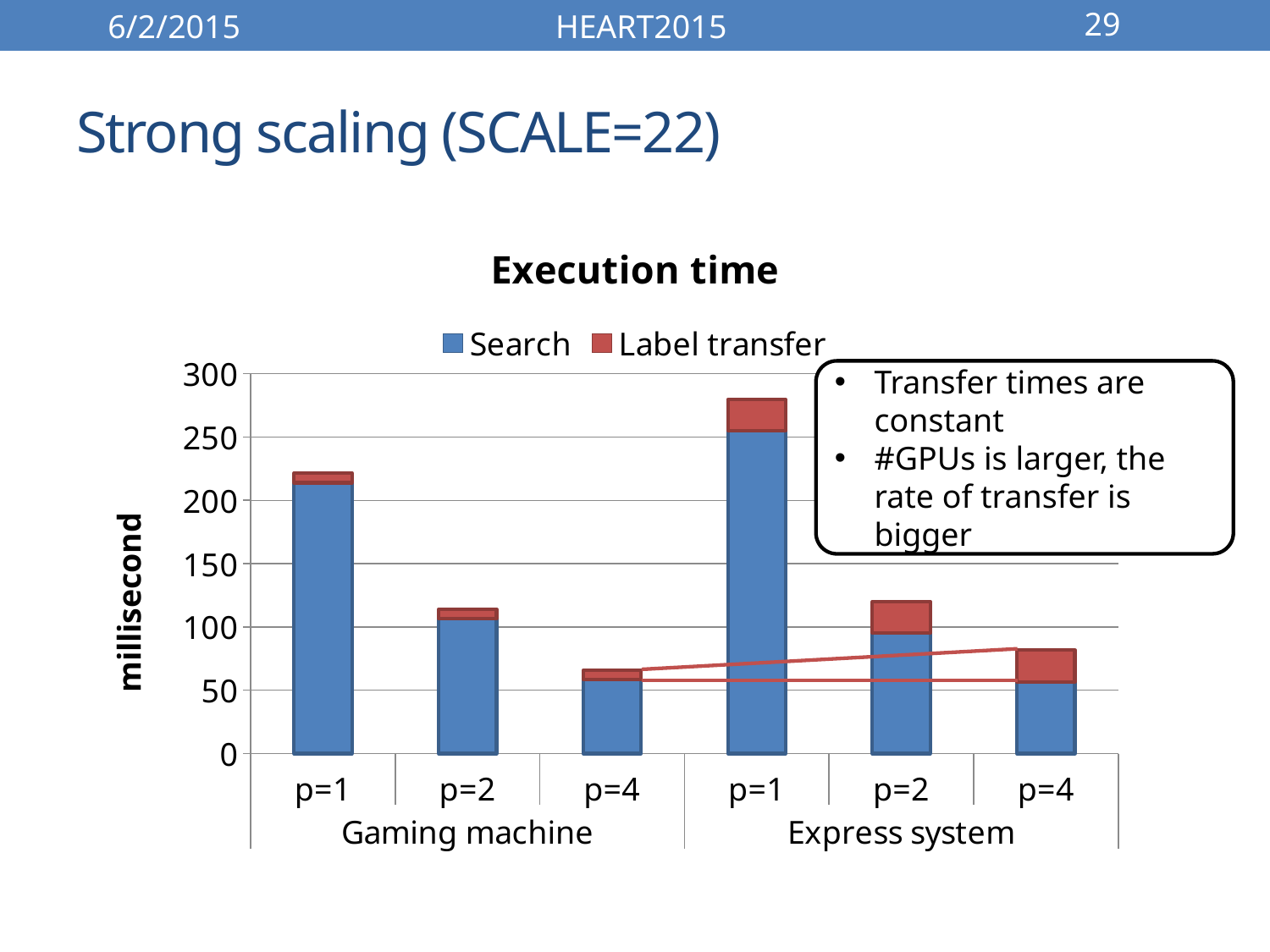
Is the total execution time for Gaming machine p=2 greater or less than 150? less What kind of chart is shown on the slide? Stacked bar chart Which bar has the highest total execution time? Express system p=1 Which has the larger total execution time: Gaming machine p=4 or Express system p=4? Express system p=4 How many series does the legend of the Execution time chart list? 2 Is the total execution time for Express system p=1 greater or less than 250? greater Which bar has the lowest total execution time? Gaming machine p=4 Is the total execution time for Express system p=4 greater or less than 100? less What is the label on the vertical axis of the chart? millisecond How many bars are plotted in the Execution time chart? 6 Within the Gaming machine group, does the total execution time rise or fall as p increases from 1 to 4? Fall